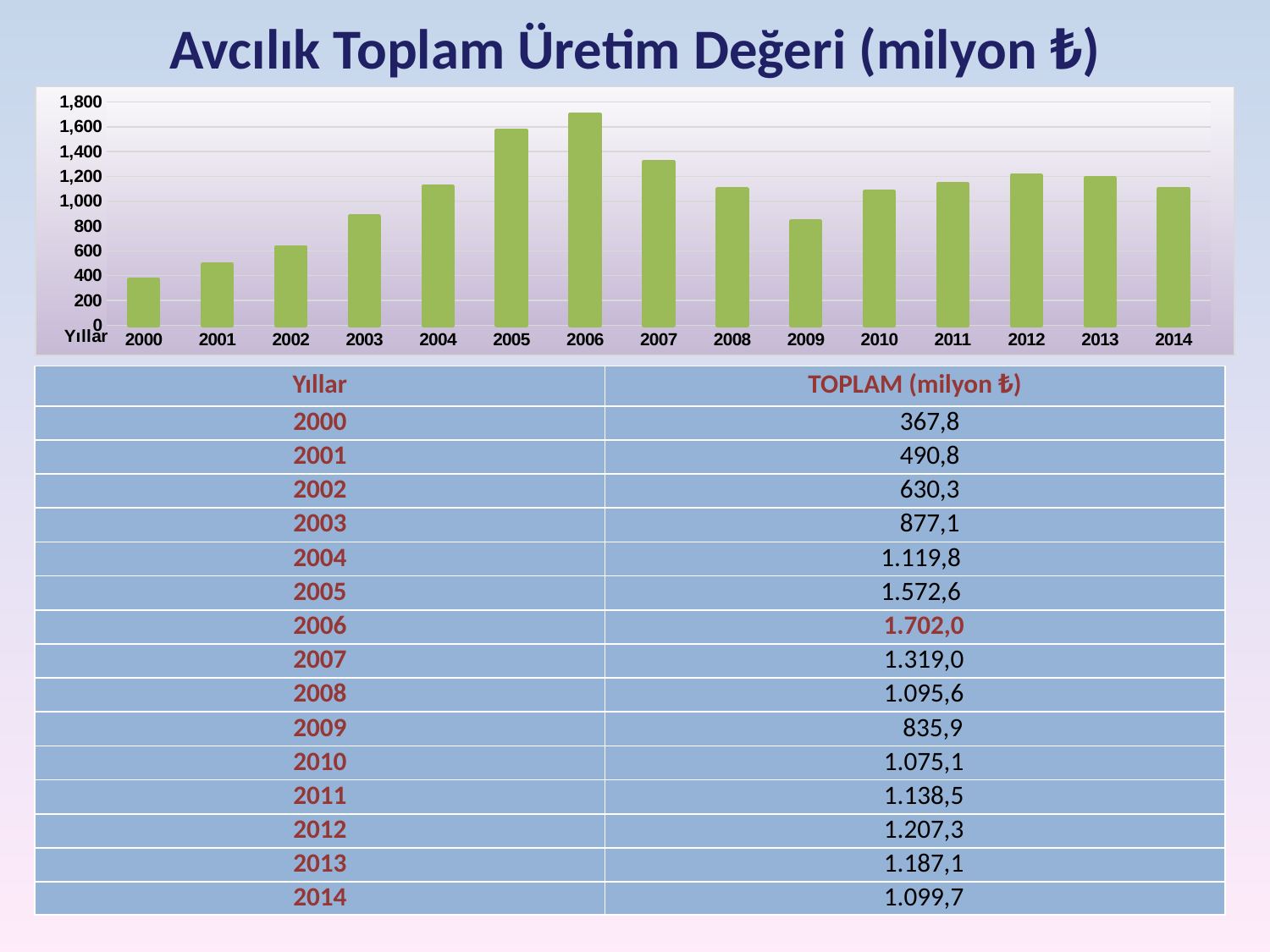
Do the values rise or fall from 2000 to 2006? rise What is the difference between the values for 2006 and 2005 (milyon ₺)? 129,4 Is the value for 2005 greater or less than 1,400? greater Which is larger, the value for 2007 or the value for 2008? 2007 Which year has the highest total production value? 2006 What type of chart is shown on the slide? bar chart What is the total production value (milyon ₺) for 2006? 1.702,0 How many years are plotted in the chart? 15 What is the total production value (milyon ₺) for 2014? 1.099,7 Which year has the lowest total production value? 2000 What is the total production value (milyon ₺) for 2009? 835,9 Is the value for 2003 greater or less than 1,000? less